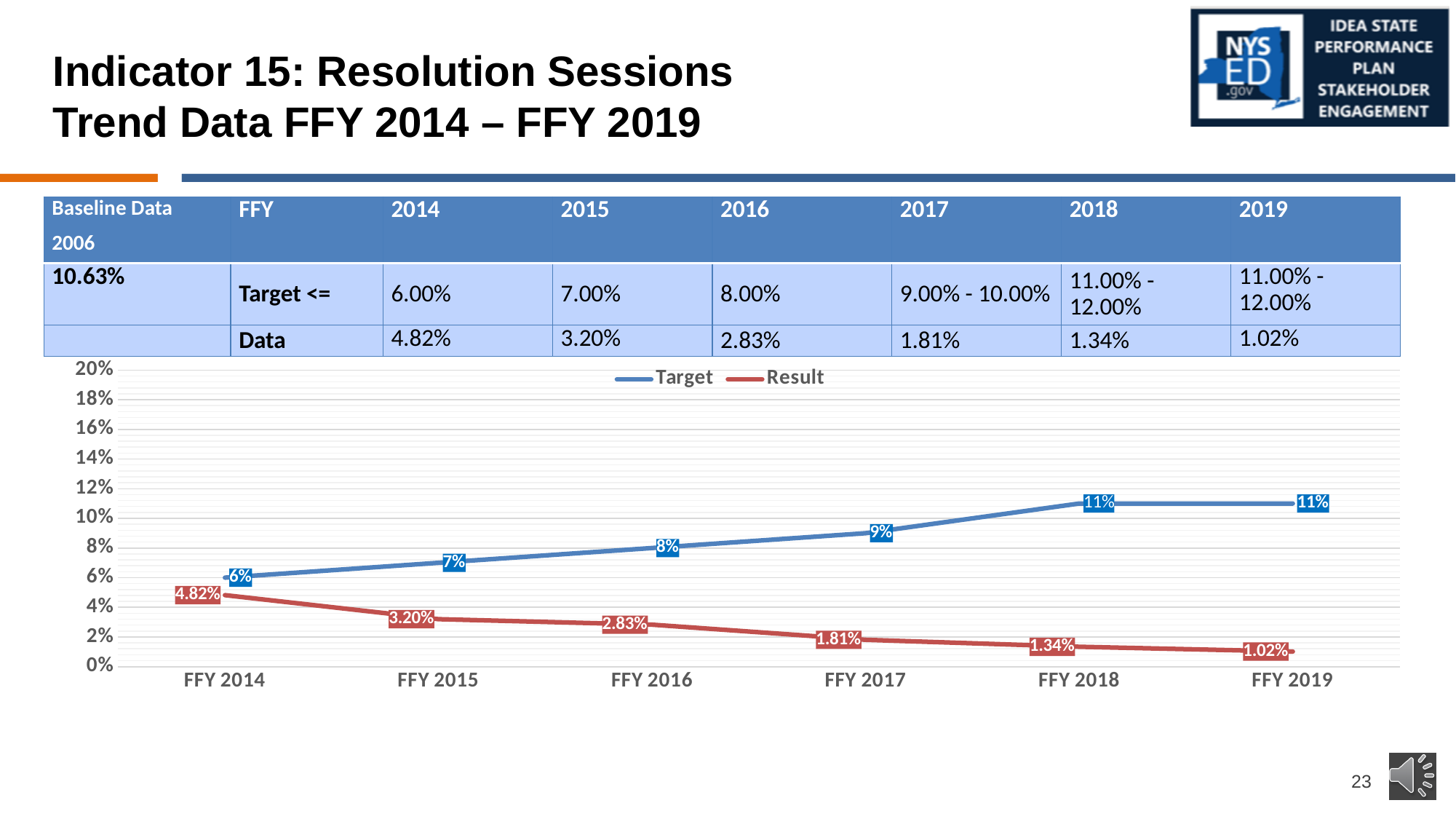
What colour is the Target line in the chart? blue Which is larger in FFY 2018, the Target value or the Result value? Target What is the Result value for FFY 2019 in the chart? 1.02% In which FFY is the Result value highest? FFY 2014 How many series does the chart legend list? 2 How many FFY categories are plotted on the x axis of the chart? 6 What is the Target value for FFY 2017 in the chart? 9% What is the difference between the Result values for FFY 2014 and FFY 2015? 1.62% What is the Result value for FFY 2016 in the chart? 2.83% What type of chart is shown on the slide? line chart In which FFY is the Result value lowest? FFY 2019 Does the Result line rise or fall from FFY 2014 to FFY 2019? fall